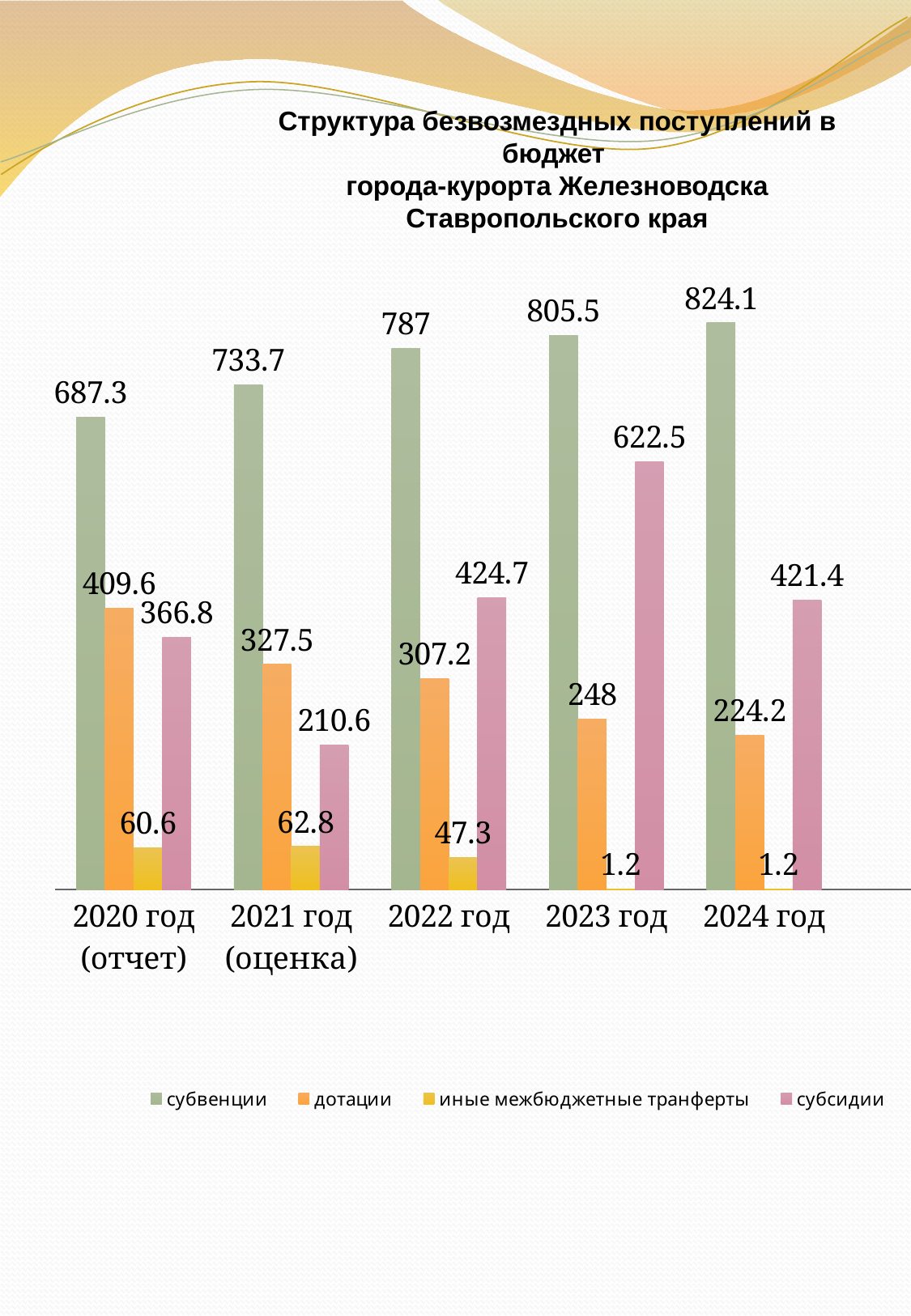
What is the value of субсидии for 2023 год? 622.5 What is the difference between субвенции in 2024 год and 2020 год (отчет)? 136.8 In which year is субсидии lowest? 2021 год (оценка) What is the value of дотации for 2020 год (отчет)? 409.6 What type of chart is shown on the slide? bar chart Which is larger in 2022 год: дотации or субсидии? субсидии Do the values of дотации rise or fall from 2020 год to 2024 год? fall What is the value of иные межбюджетные транферты for 2024 год? 1.2 How many year categories are shown on the x axis? 5 What is the value of субвенции for 2022 год? 787 In which year is субвенции highest? 2024 год How many series does the legend list? 4